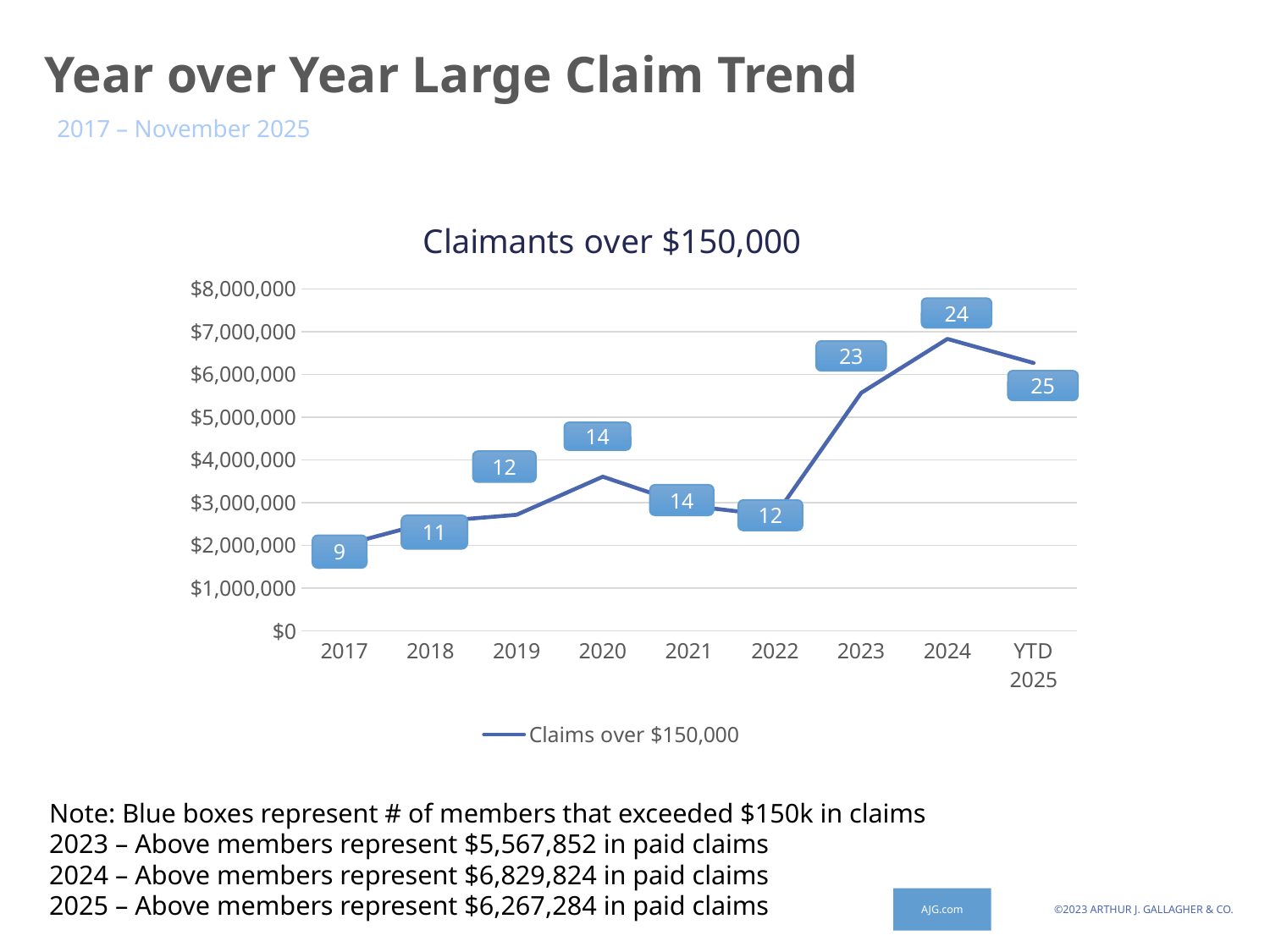
How many points are plotted along the x axis of the chart? 9 Which year has the lowest value on the Claims over $150,000 line? 2017 What kind of chart is shown on the slide? line chart What number is shown in the blue box for 2017? 9 How many series does the chart's legend list? 1 What number is shown in the blue box for 2024? 24 What is the difference between the blue box numbers for 2024 and 2017? 15 Which year has the larger value on the Claims over $150,000 line, 2020 or 2021? 2020 Which year has the highest value on the Claims over $150,000 line? 2024 Is the value for 2020 on the Claims over $150,000 line greater or less than $3,000,000? greater What number is shown in the blue box for YTD 2025? 25 Is the value for 2023 on the Claims over $150,000 line greater or less than $5,000,000? greater